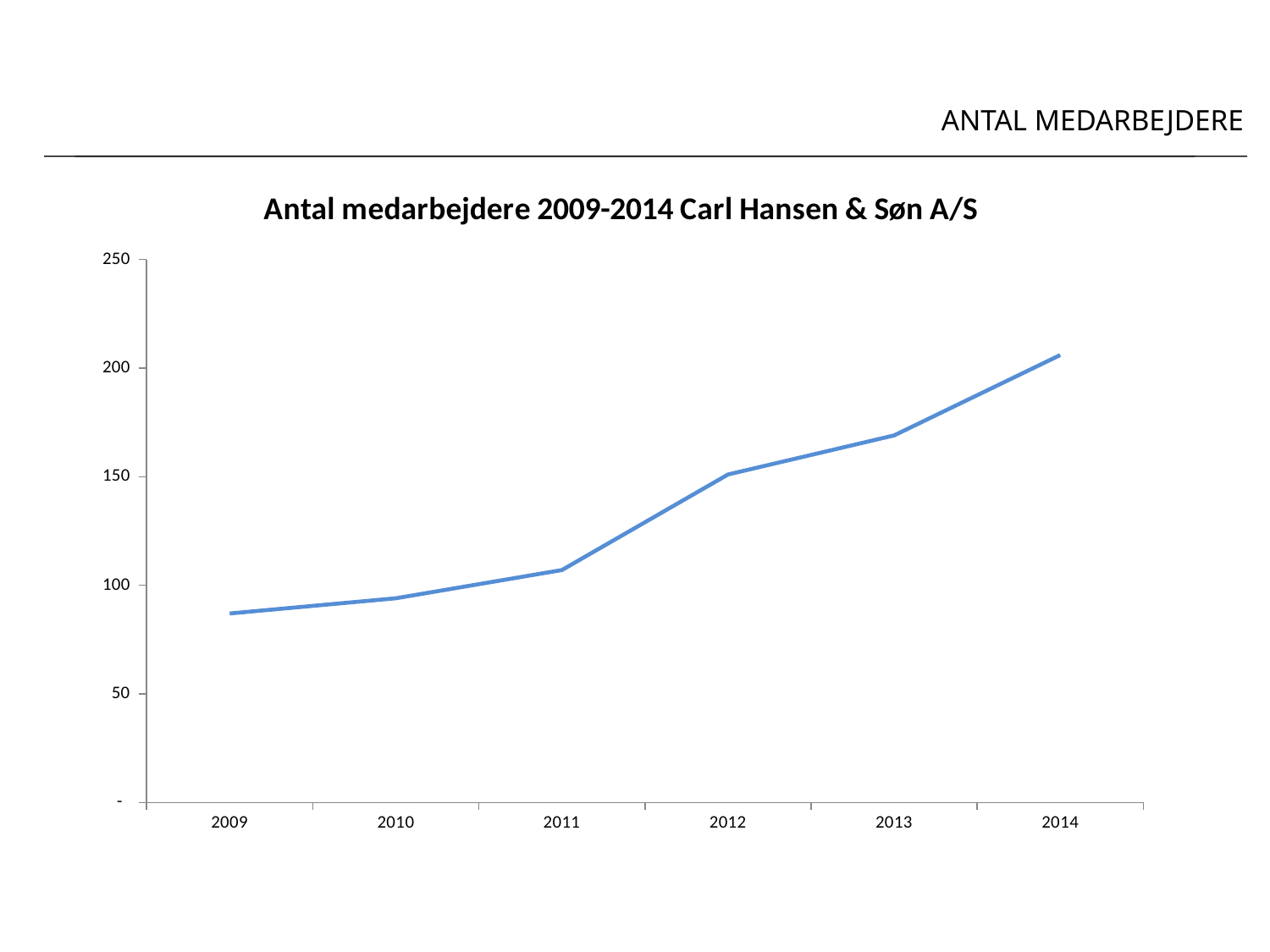
Is the value for 2012 greater or less than 200? less Is the value for 2014 greater or less than 200? greater Which year has the larger value, 2011 or 2013? 2013 Do the values rise or fall from 2009 to 2014? rise Is the value for 2009 greater or less than 100? less Which year has the lowest number of employees? 2009 Which year has the larger value, 2010 or 2012? 2012 How many years are plotted on the x axis? 6 What is the title of the chart? Antal medarbejdere 2009-2014 Carl Hansen & Søn A/S What kind of chart is shown on the slide? line chart Which year has the highest number of employees? 2014